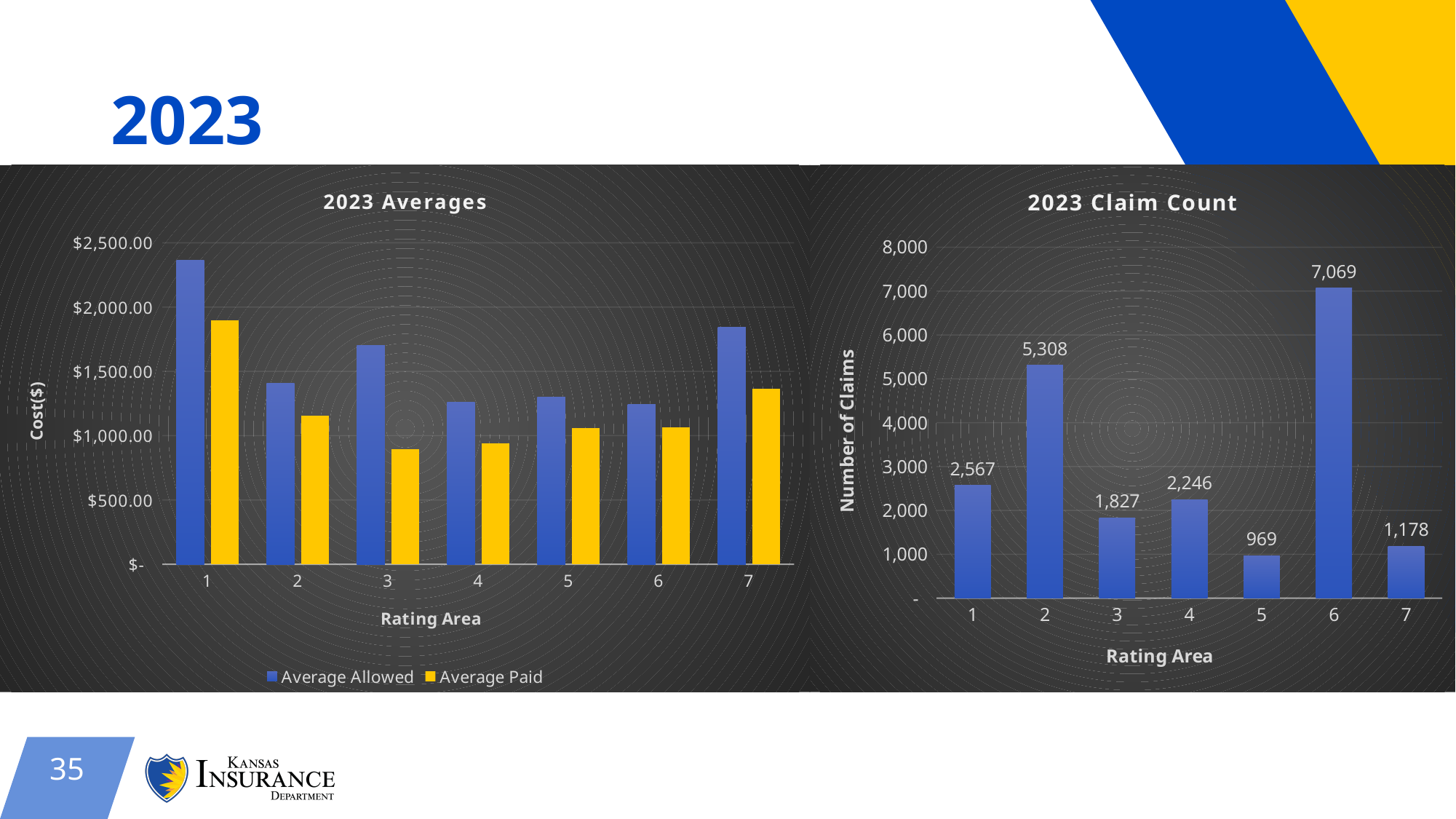
In the 2023 Averages chart, how many series does the legend list? 2 In the 2023 Averages chart, is the Average Allowed value for rating area 1 greater or less than $2,000.00? greater In the 2023 Claim Count chart, which rating area has the lowest number of claims? 5 In the 2023 Claim Count chart, which rating area has the highest number of claims? 6 What kind of chart is the 2023 Averages chart? Bar chart In the 2023 Claim Count chart, how many claims are shown for rating area 5? 969 In the 2023 Claim Count chart, which has more claims, rating area 3 or rating area 4? Rating area 4 In the 2023 Averages chart, which rating area has the highest Average Allowed value? 1 In the 2023 Claim Count chart, how many rating areas are shown on the x axis? 7 In the 2023 Averages chart, is the Average Paid value for rating area 3 greater or less than $1,000.00? less In the 2023 Claim Count chart, how many claims are shown for rating area 6? 7,069 In the 2023 Claim Count chart, what is the difference in claims between rating area 2 and rating area 1? 2,741